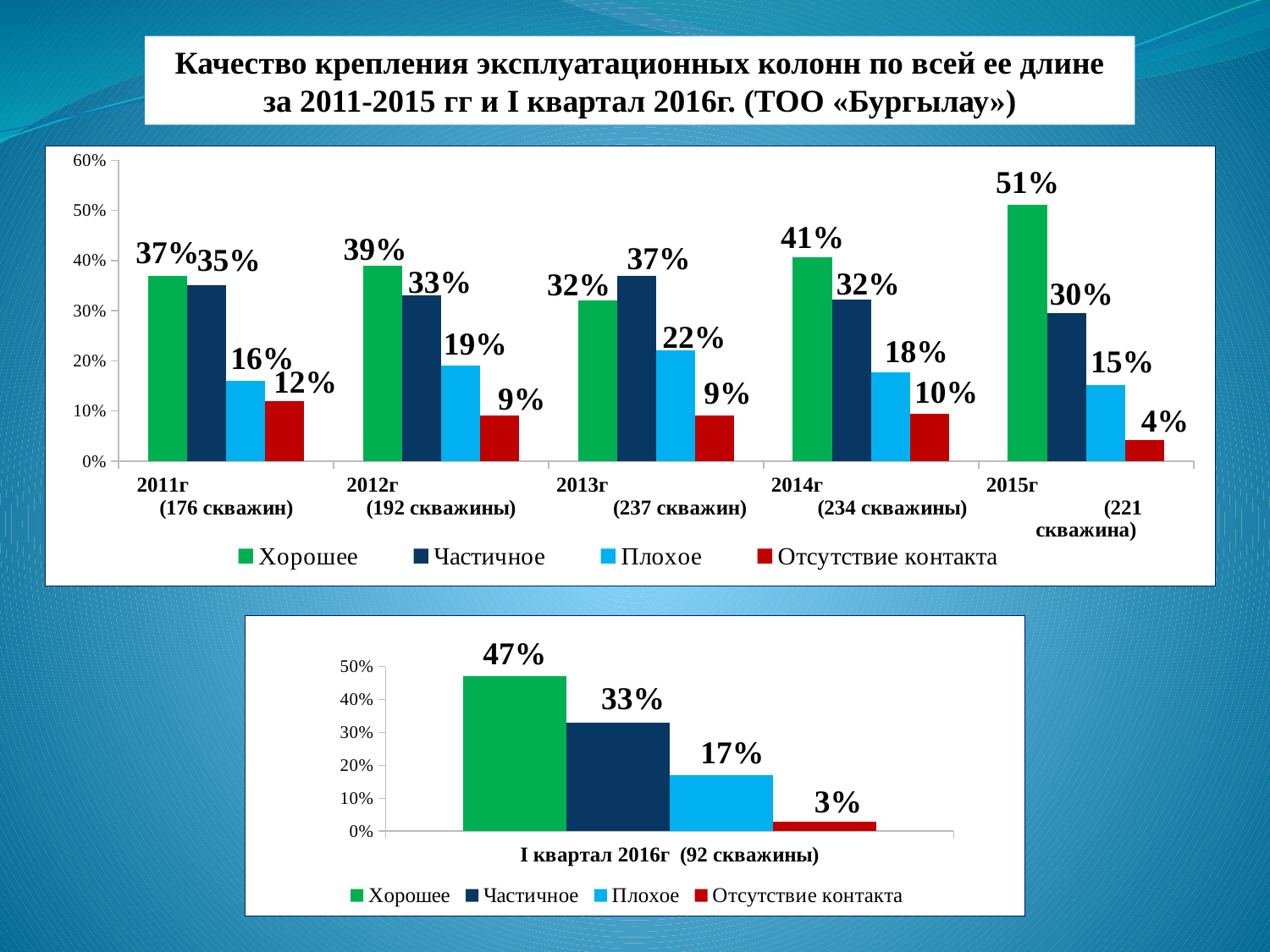
In the top chart (2011–2015), how many year categories are shown on the x axis? 5 In the top chart (2011–2015), what is the difference between Хорошее and Частичное in 2014г? 9% In the bottom chart (I квартал 2016г), what is the difference between Хорошее and Частичное? 14% In the bottom chart (I квартал 2016г), what is the value for Плохое? 17% In the top chart (2011–2015), which year has the highest value for Хорошее? 2015г In the top chart (2011–2015), what is the value for Хорошее in 2015г? 51% In the top chart (2011–2015), does the value for Плохое rise or fall from 2013г to 2015г? fall In the top chart (2011–2015), what is the value for Отсутствие контакта in 2011г? 12% What kind of chart is the bottom chart (I квартал 2016г)? bar chart In the top chart (2011–2015), which is larger in 2013г: Хорошее or Частичное? Частичное In the top chart (2011–2015), which year has the lowest value for Отсутствие контакта? 2015г In the top chart (2011–2015), how many series does the legend list? 4